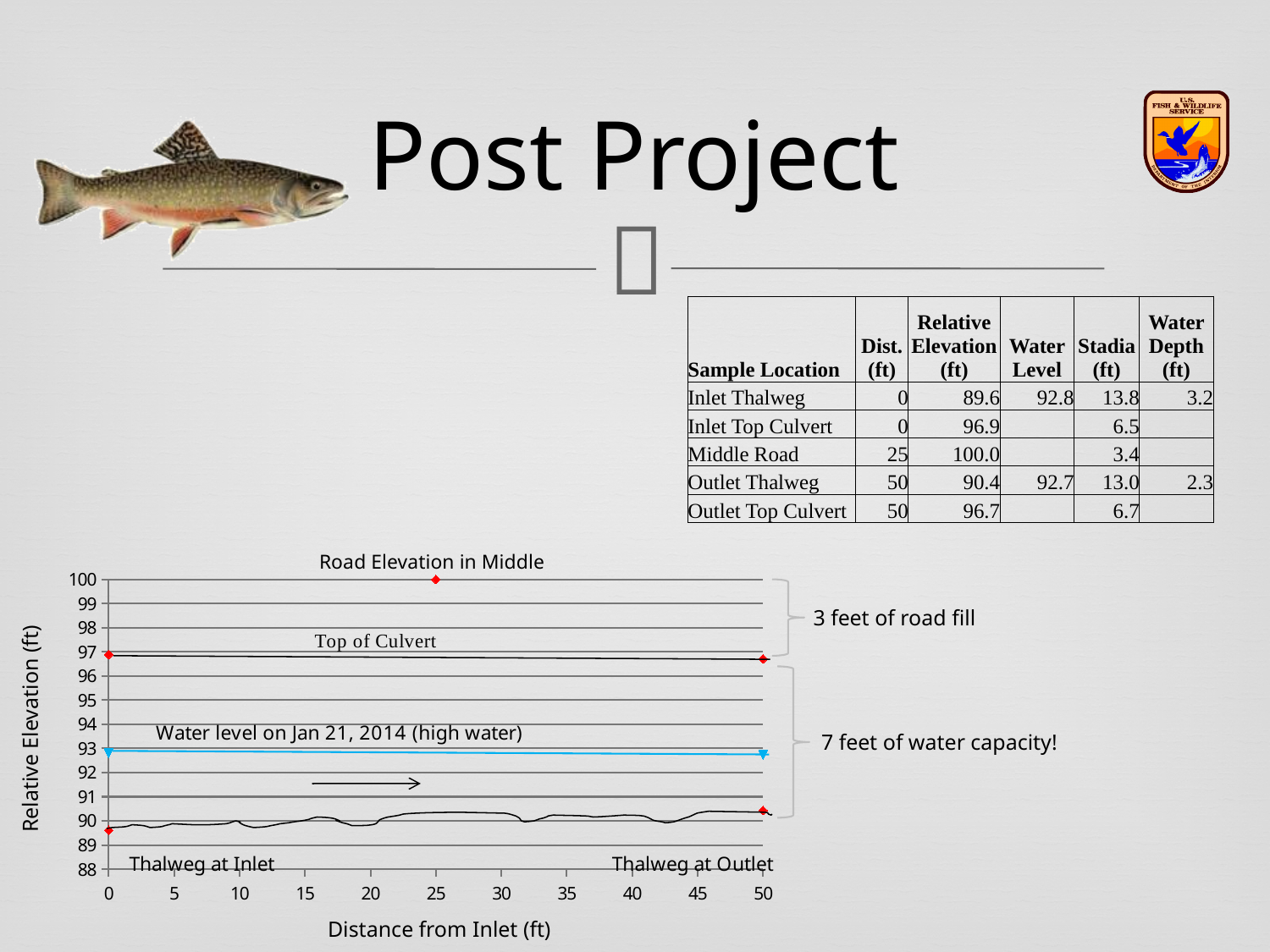
Is the relative elevation of the Thalweg at Inlet greater or less than 90? less Is the water level line at the inlet (distance 0) greater or less than 92? greater According to the table on the slide, what is the relative elevation of the Inlet Thalweg plotted on the chart? 89.6 What is the title of the y axis of the chart? Relative Elevation (ft) What is the relative elevation of the point labeled "Road Elevation in Middle"? 100 What is the title of the x axis of the chart? Distance from Inlet (ft) Which labeled point on the chart has the highest relative elevation? Road Elevation in Middle Which is higher on the chart, the Top of Culvert line or the water level line? Top of Culvert Which labeled point on the chart has the lowest relative elevation? Thalweg at Inlet Is the Top of Culvert line at the inlet (distance 0) greater or less than 96? greater Does the thalweg line rise or fall from the inlet to the outlet? rise What kind of chart is shown on the slide? line chart